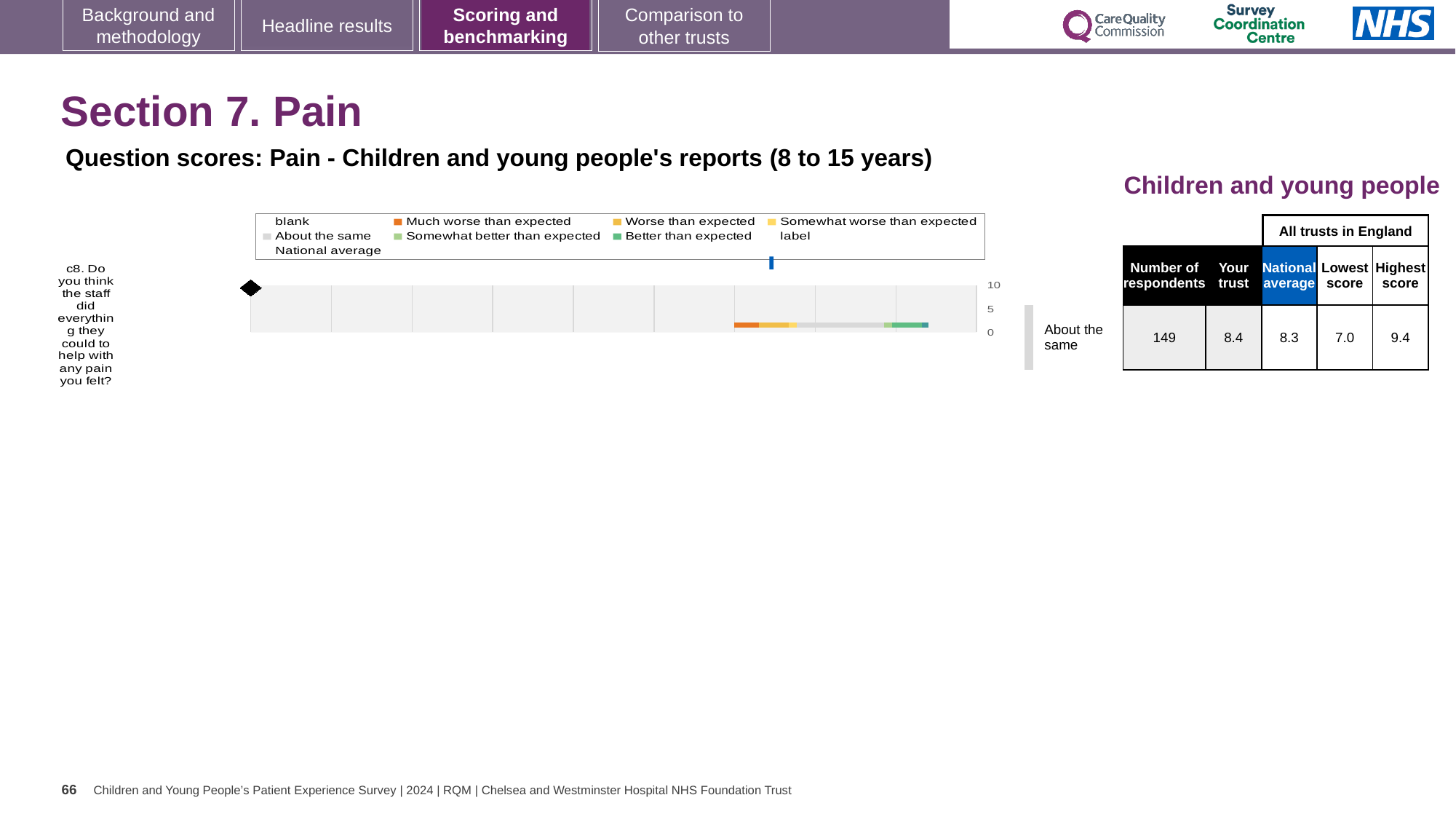
What is the 'Your trust' score for question c8 (Do you think the staff did everything they could to help with any pain you felt?)? 8.4 Which benchmarking category is the trust's score for question c8 placed in? About the same Which is higher for question c8: the 'Your trust' score or the national average? Your trust What is the difference between the highest score and the lowest score for question c8? 2.4 What kind of chart is used to show the question score for c8? Bar chart What colour in the legend represents 'Much worse than expected'? Orange How many questions are plotted on the chart? 1 What is the national average score for question c8? 8.3 What is the highest score among all trusts in England for question c8? 9.4 What is the lowest score among all trusts in England for question c8? 7.0 Is the trust's score for question c8 greater or less than 5 on the chart's axis? greater How many respondents answered question c8? 149